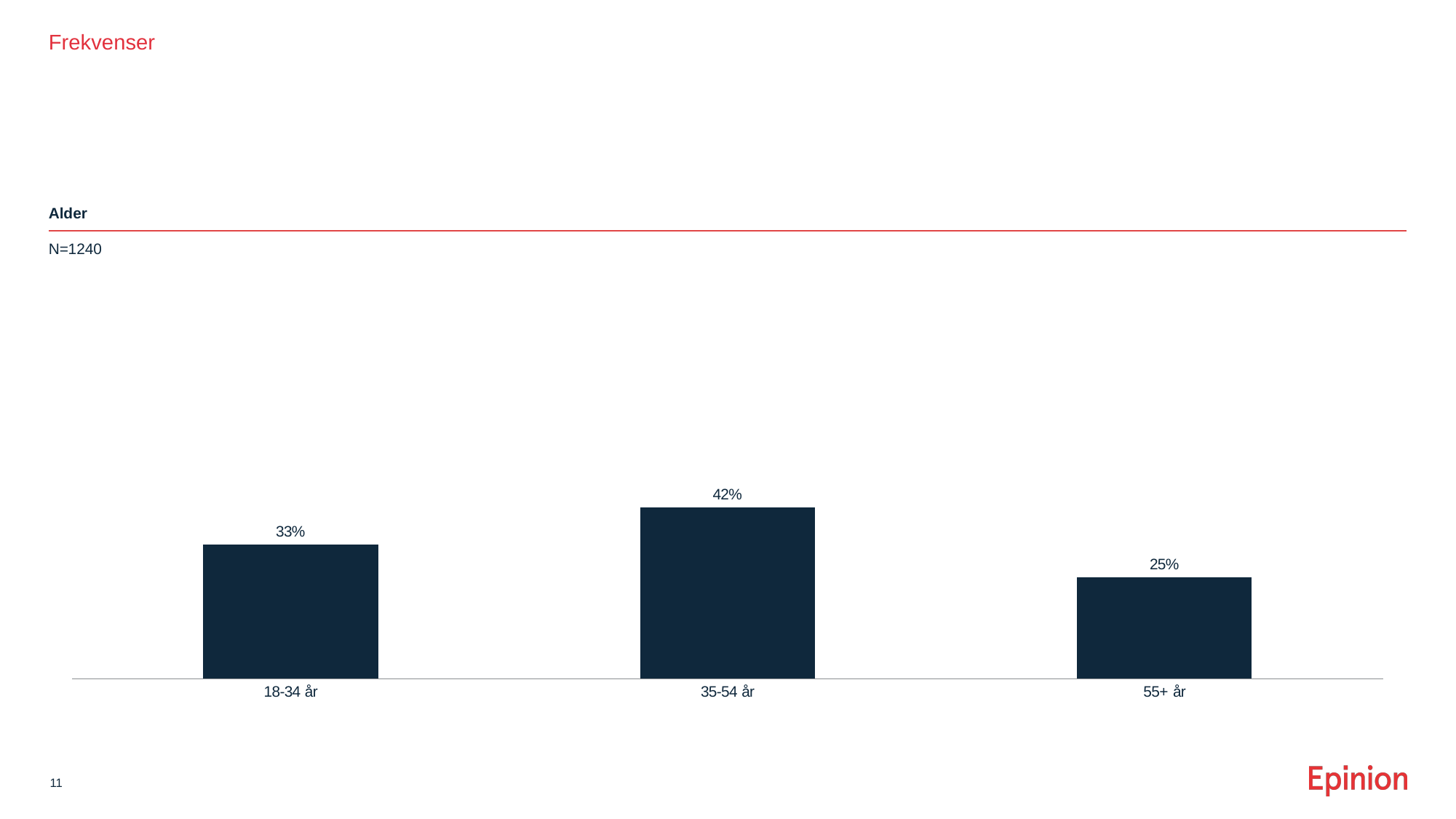
Which age group has the lowest value? 55+ år What is the title of the chart? Alder What is the value for 55+ år? 25% What sample size (N) is stated for the chart? N=1240 What is the difference between the values for 18-34 år and 55+ år? 8% Which is larger, the value for 18-34 år or the value for 55+ år? 18-34 år What is the value for 18-34 år? 33% How many age groups are shown in the chart? 3 Which age group has the highest value? 35-54 år What is the difference between the values for 35-54 år and 18-34 år? 9% What kind of chart is shown on the slide? Bar chart What is the value for 35-54 år? 42%